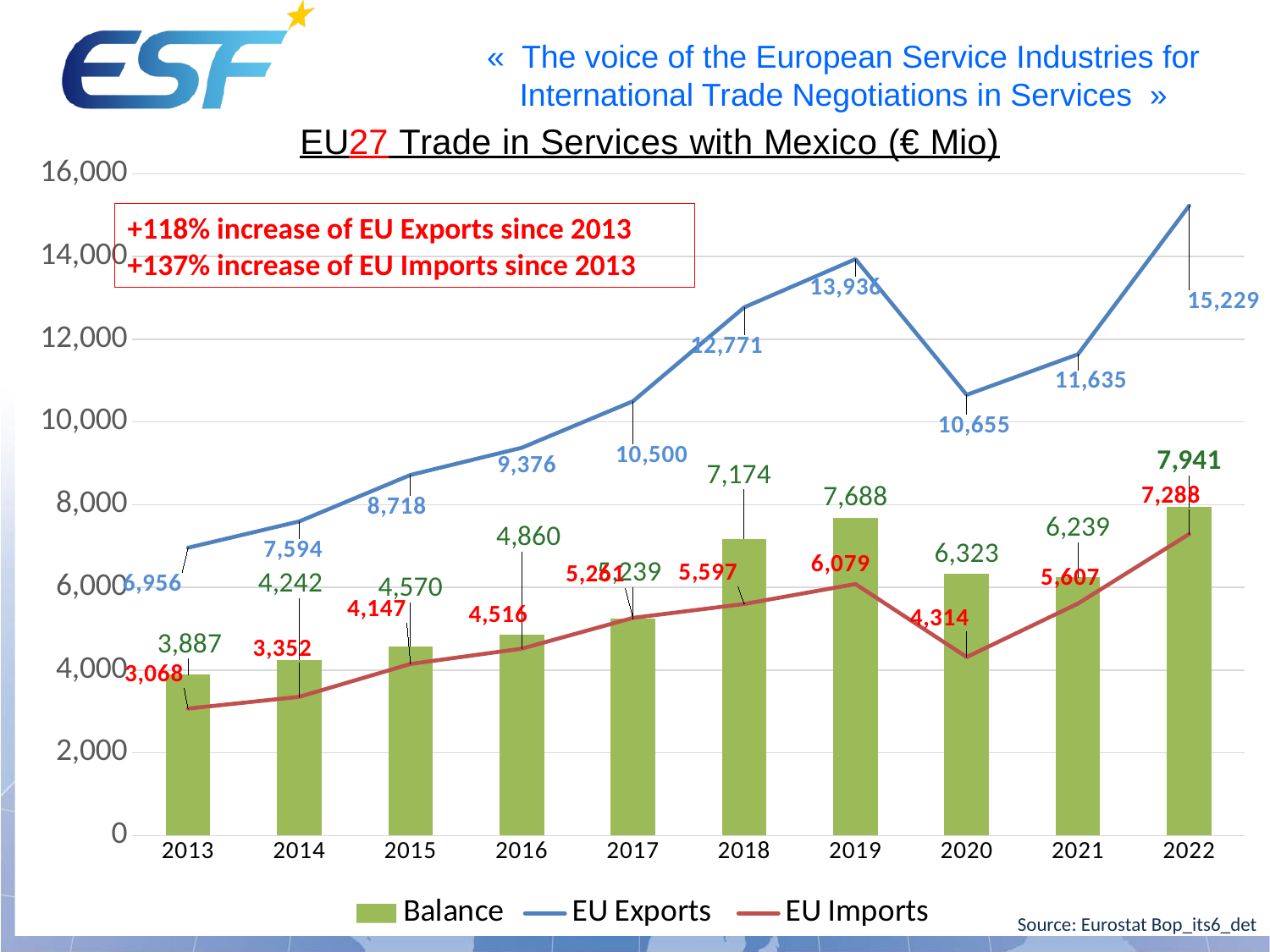
What is the value of EU Exports in 2022? 15,229 In which year are EU Exports highest? 2022 Do EU Exports rise or fall from 2013 to 2019? Rise In which year is the Balance lowest? 2013 How many years are shown on the x axis? 10 How many series does the legend list? 3 What is the Balance value for 2018? 7,174 By how much did EU Exports increase from 2021 to 2022? 3,594 Is the value for EU Exports in 2020 greater or less than 10,000? greater What is the value of EU Imports in 2019? 6,079 Which year has higher EU Imports, 2020 or 2021? 2021 What kind of chart is this? Combined bar and line chart